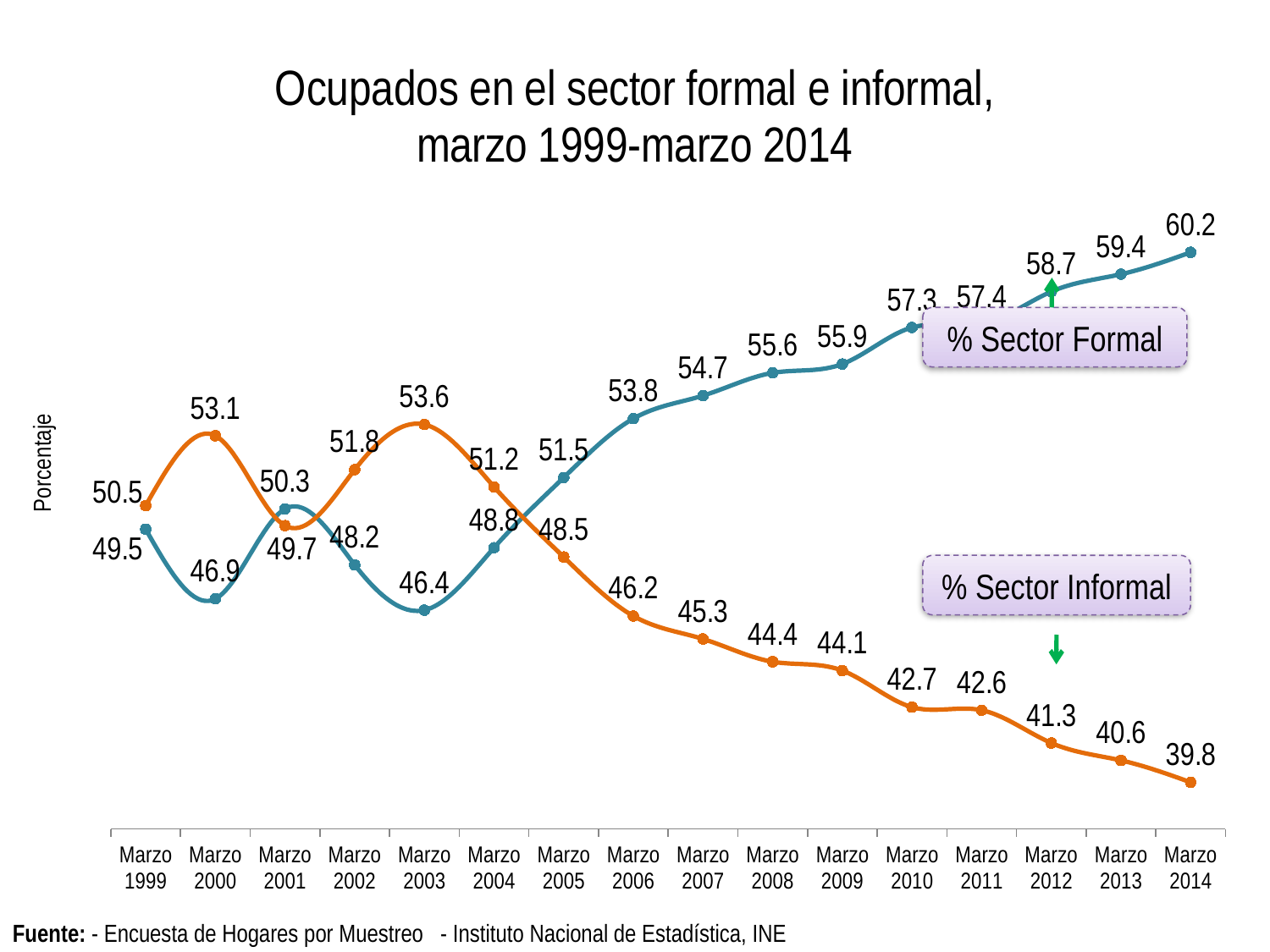
In which year does % Sector Formal reach its lowest value? Marzo 2003 What is the value of % Sector Formal in Marzo 2014? 60.2 What is the difference between % Sector Formal and % Sector Informal in Marzo 2014? 20.4 From Marzo 2005 to Marzo 2014, does % Sector Informal rise or fall? Fall In which year does % Sector Informal reach its highest value? Marzo 2003 What kind of chart is shown on the slide? Line chart Which is larger in Marzo 2000, % Sector Formal or % Sector Informal? % Sector Informal What is the value of % Sector Informal in Marzo 1999? 50.5 What is the value of % Sector Formal in Marzo 2003? 46.4 How many time points are plotted on the x axis? 16 How many series are shown in the chart? 2 What is the value of % Sector Informal in Marzo 2008? 44.4